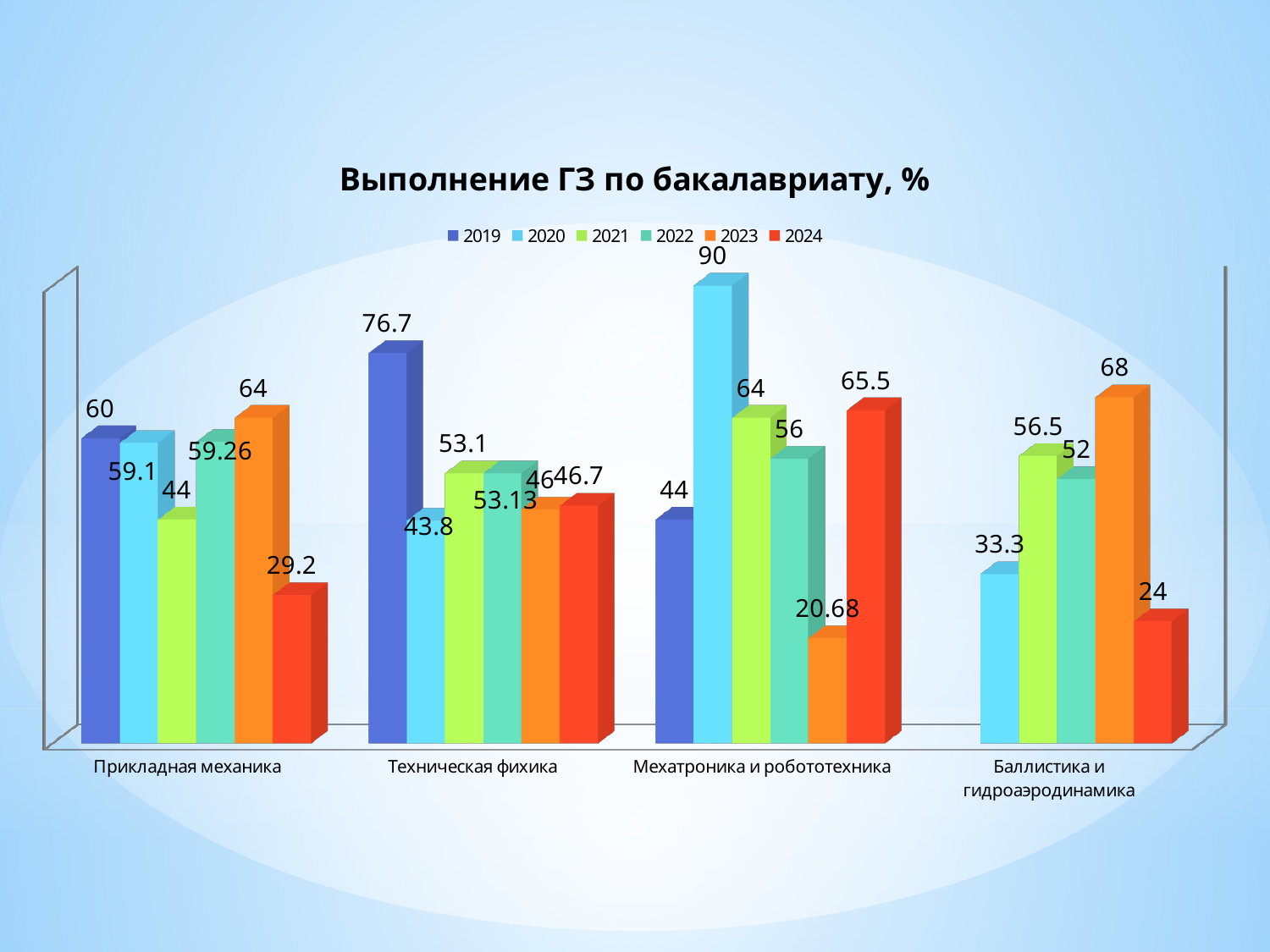
Which year has the lowest value in the Мехатроника и робототехника category? 2023 Which is larger in the Техническая фихика category: the 2019 value or the 2020 value? 2019 What is the difference between the 2023 and 2024 values in the Баллистика и гидроаэродинамика category? 44 How many series does the legend list? 6 What is the value for 2023 in the Баллистика и гидроаэродинамика category? 68 What is the value for 2019 in the Техническая фихика category? 76.7 What kind of chart is shown on the slide? Bar chart What is the value for 2020 in the Мехатроника и робототехника category? 90 How many categories are shown on the x axis? 4 Which category has the highest value for the 2020 series? Мехатроника и робототехника What is the value for 2024 in the Прикладная механика category? 29.2 What is the title of the chart? Выполнение ГЗ по бакалавриату, %